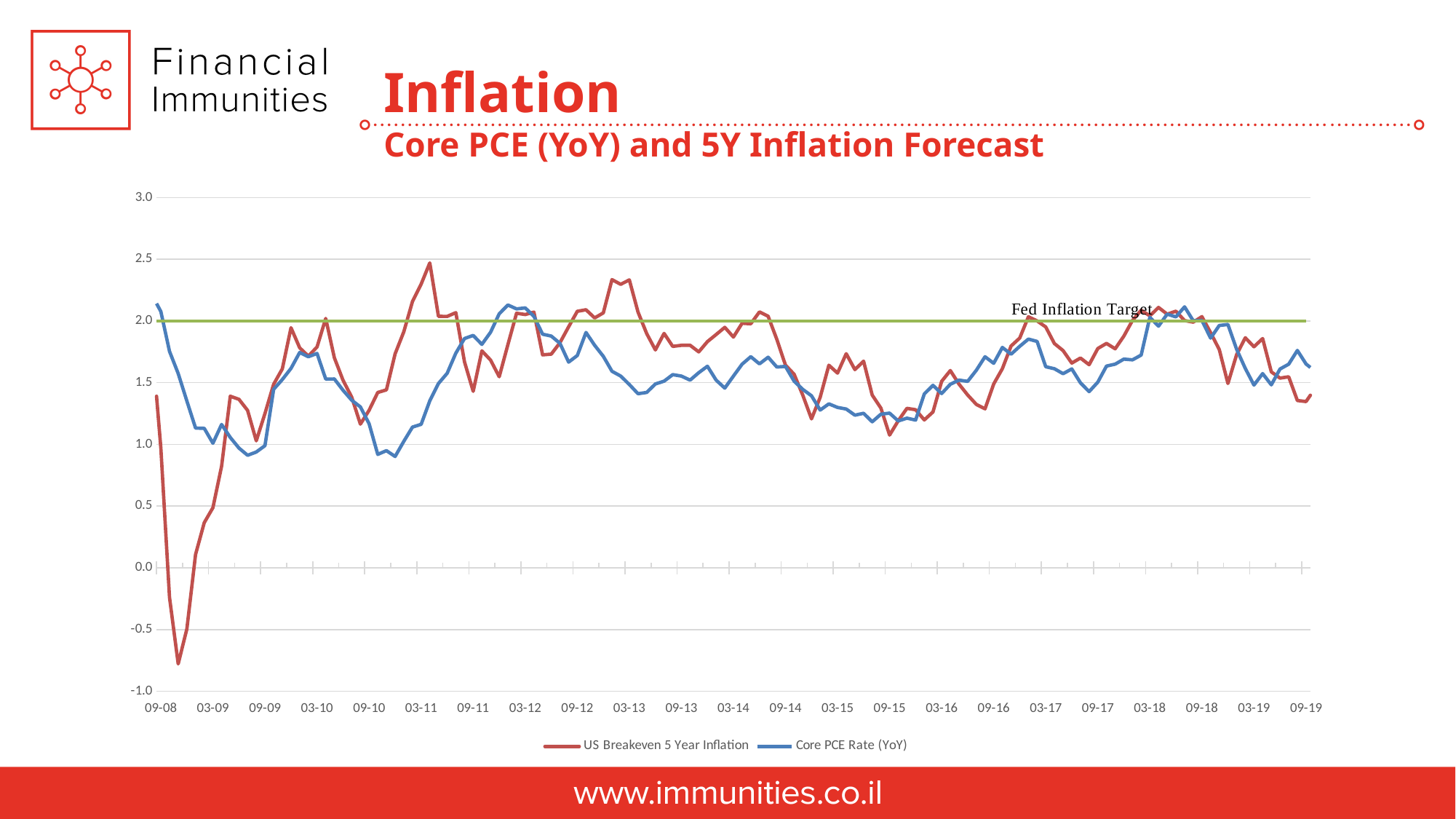
How many series does the chart legend list? 2 Is the value of Core PCE Rate (YoY) at 09-10 greater or less than 1.5? less What label is attached to the green horizontal line on the chart? Fed Inflation Target Is the value of Core PCE Rate (YoY) at 09-19 greater or less than 2.0? less At 09-19, which series is higher: US Breakeven 5 Year Inflation or Core PCE Rate (YoY)? Core PCE Rate (YoY) Does the US Breakeven 5 Year Inflation series fall below 0.0 at any point? yes Does the Core PCE Rate (YoY) series rise or fall between 09-08 and 03-09? fall What is the title of the chart? Core PCE (YoY) and 5Y Inflation Forecast At what value is the Fed Inflation Target line drawn? 2.0 What kind of chart is shown on the slide? line chart At 03-11, which series is higher: US Breakeven 5 Year Inflation or Core PCE Rate (YoY)? US Breakeven 5 Year Inflation